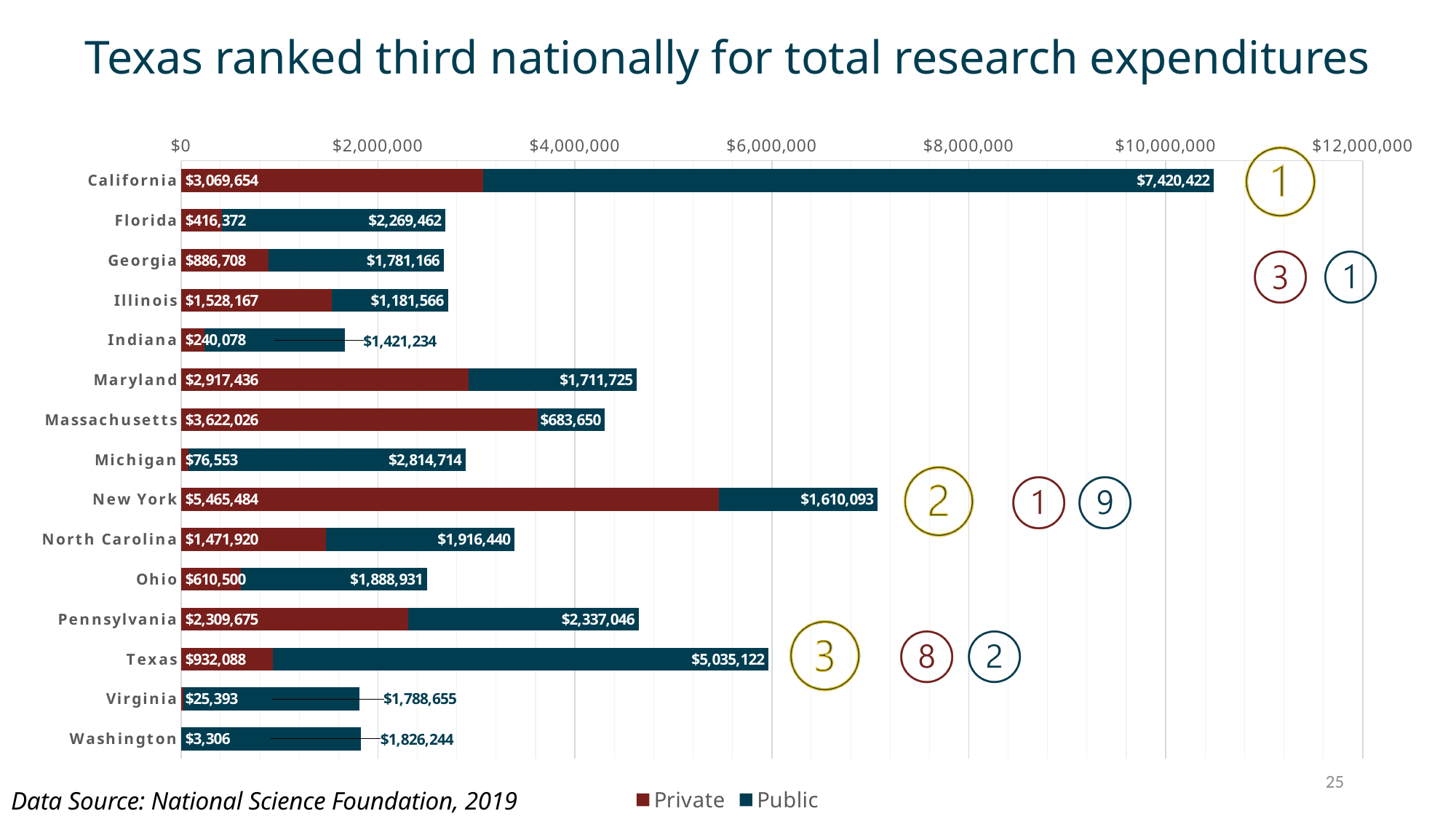
Which state has the highest Public expenditure value? California Is the total bar length for California greater or less than $10,000,000? greater Which state has the lowest Private expenditure value? Washington How many series does the legend list? 2 What is the total research expenditure (Private plus Public) for Texas? $5,967,210 What is the difference between California's Public value and Texas's Public value? $2,385,300 Which colour represents the Private series in the legend? Dark red Which is larger for Massachusetts, the Private value or the Public value? Private What type of chart is shown on the slide? Stacked bar chart What is the Private research expenditure value for New York? $5,465,484 What is the Public research expenditure value for Texas? $5,035,122 How many states are shown on the chart? 15